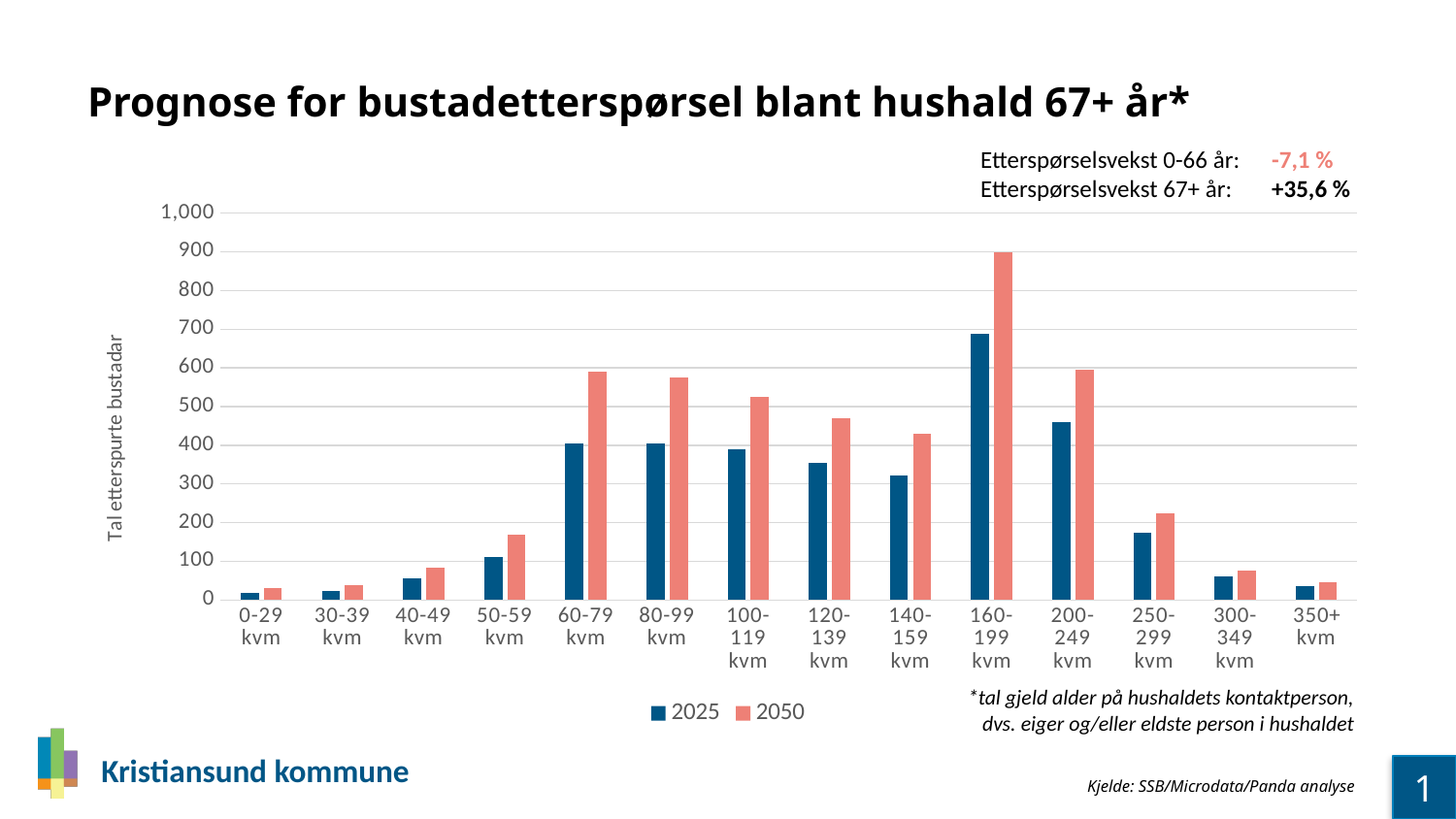
Which size category has the highest value for the 2050 series? 160-199 kvm Which size category has the lowest value for the 2025 series? 0-29 kvm How many size categories (kvm groups) are shown on the x axis? 14 Is the 2050 value for 60-79 kvm greater or less than 500? greater For 60-79 kvm, which series has the larger value, 2025 or 2050? 2050 For the 2025 series, which is larger: 160-199 kvm or 200-249 kvm? 160-199 kvm What kind of chart is shown on the slide? Bar chart How many series does the legend list? 2 Which size category has the highest value for the 2025 series? 160-199 kvm Is the 2025 value for 160-199 kvm greater or less than 600? greater Is the 2025 value for 350+ kvm greater or less than 100? less What is the label on the vertical axis of the chart? Tal etterspurte bustadar